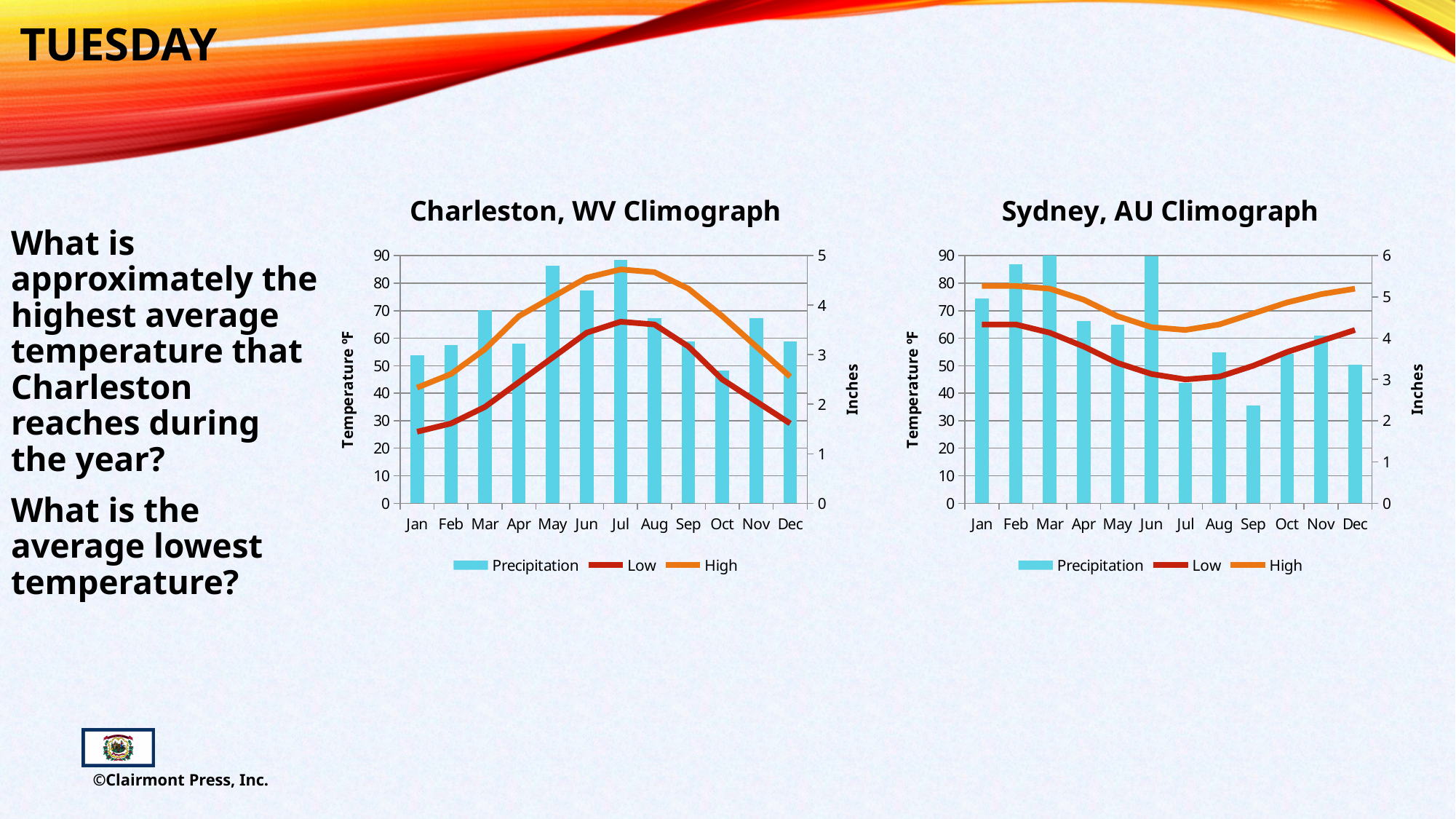
In the Sydney, AU Climograph, which is larger, the precipitation bar for Jan or for Sep? Jan In the Sydney, AU Climograph, is the High temperature in Jul greater or less than 70? less In the Charleston, WV Climograph, is the High temperature in Jul greater or less than 80? greater In the Sydney, AU Climograph, which month has the lowest precipitation bar? Sep How many months are shown on the x axis of the Charleston, WV Climograph? 12 How many series does the legend of the Charleston, WV Climograph list? 3 In the Sydney, AU Climograph, is the Low temperature in Jul greater or less than 50? less What kind of chart is the Charleston, WV Climograph? A combined bar and line chart In the Charleston, WV Climograph, does the High temperature line rise or fall from Jan to Jul? Rises In the Sydney, AU Climograph, does the High temperature line rise or fall from Jan to Jul? Falls In the Charleston, WV Climograph, which month has the lowest precipitation bar? Oct